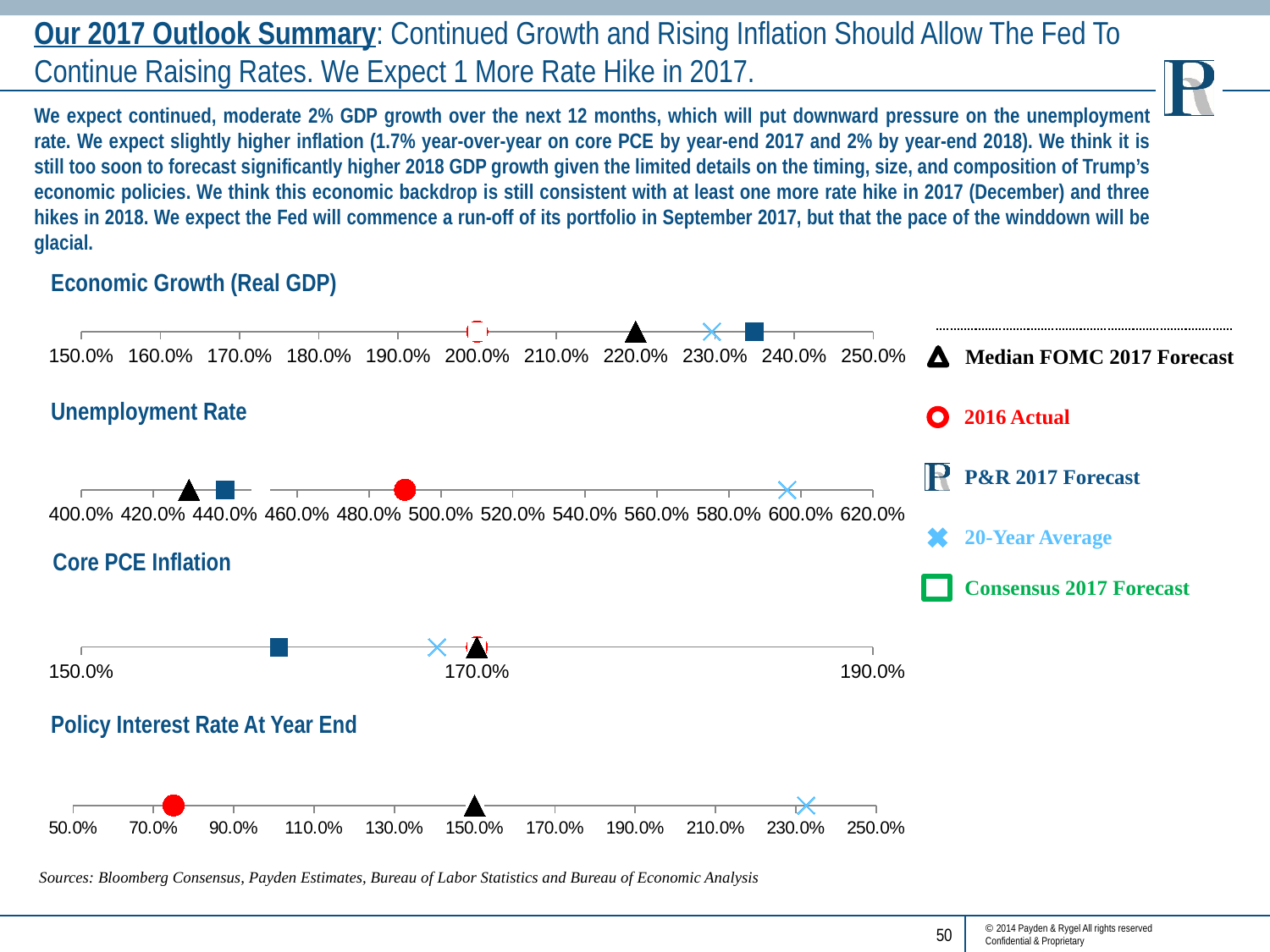
In the Unemployment Rate chart, which is larger, the 2016 Actual or the Median FOMC 2017 Forecast? 2016 Actual In the Policy Interest Rate At Year End chart, what value does the Median FOMC 2017 Forecast marker sit on? 150.0% In the Unemployment Rate chart, is the 20-Year Average value greater or less than 580.0%? greater In the Economic Growth (Real GDP) chart, what value does the Median FOMC 2017 Forecast marker sit on? 220.0% How many series does the legend on the right of the slide list? 5 In the Policy Interest Rate At Year End chart, which is larger, the 20-Year Average or the Median FOMC 2017 Forecast? 20-Year Average In the Core PCE Inflation chart, what value does the Median FOMC 2017 Forecast marker sit on? 170.0% Which legend entry is shown with a red circle marker? 2016 Actual In the Unemployment Rate chart, is the 2016 Actual value greater or less than 460.0%? greater In the Policy Interest Rate At Year End chart, is the 2016 Actual value greater or less than 90.0%? less